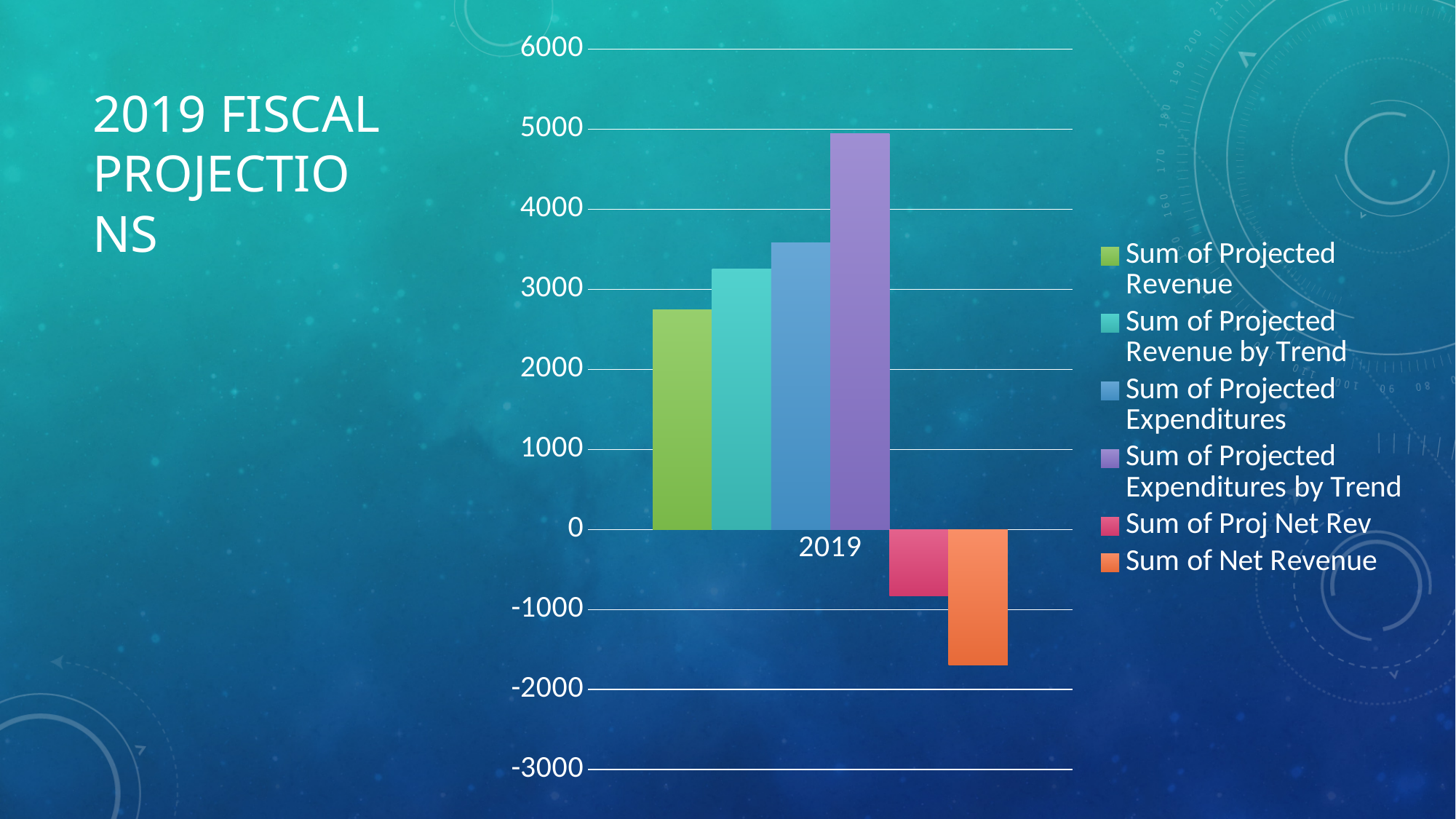
Which is larger for 2019: Sum of Projected Expenditures or Sum of Projected Expenditures by Trend? Sum of Projected Expenditures by Trend Is the value for Sum of Projected Revenue greater or less than 3000? less What kind of chart is shown on the slide? bar chart Which series has the highest value for 2019? Sum of Projected Expenditures by Trend How many categories are shown on the x axis? 1 Which is larger for 2019: Sum of Projected Revenue or Sum of Projected Revenue by Trend? Sum of Projected Revenue by Trend How many series does the legend list? 6 Is the value for Sum of Proj Net Rev greater or less than 0? less Which series has the lowest value for 2019? Sum of Net Revenue Is the value for Sum of Projected Expenditures by Trend greater or less than 4000? greater What is the title of the slide containing the chart? 2019 Fiscal Projections